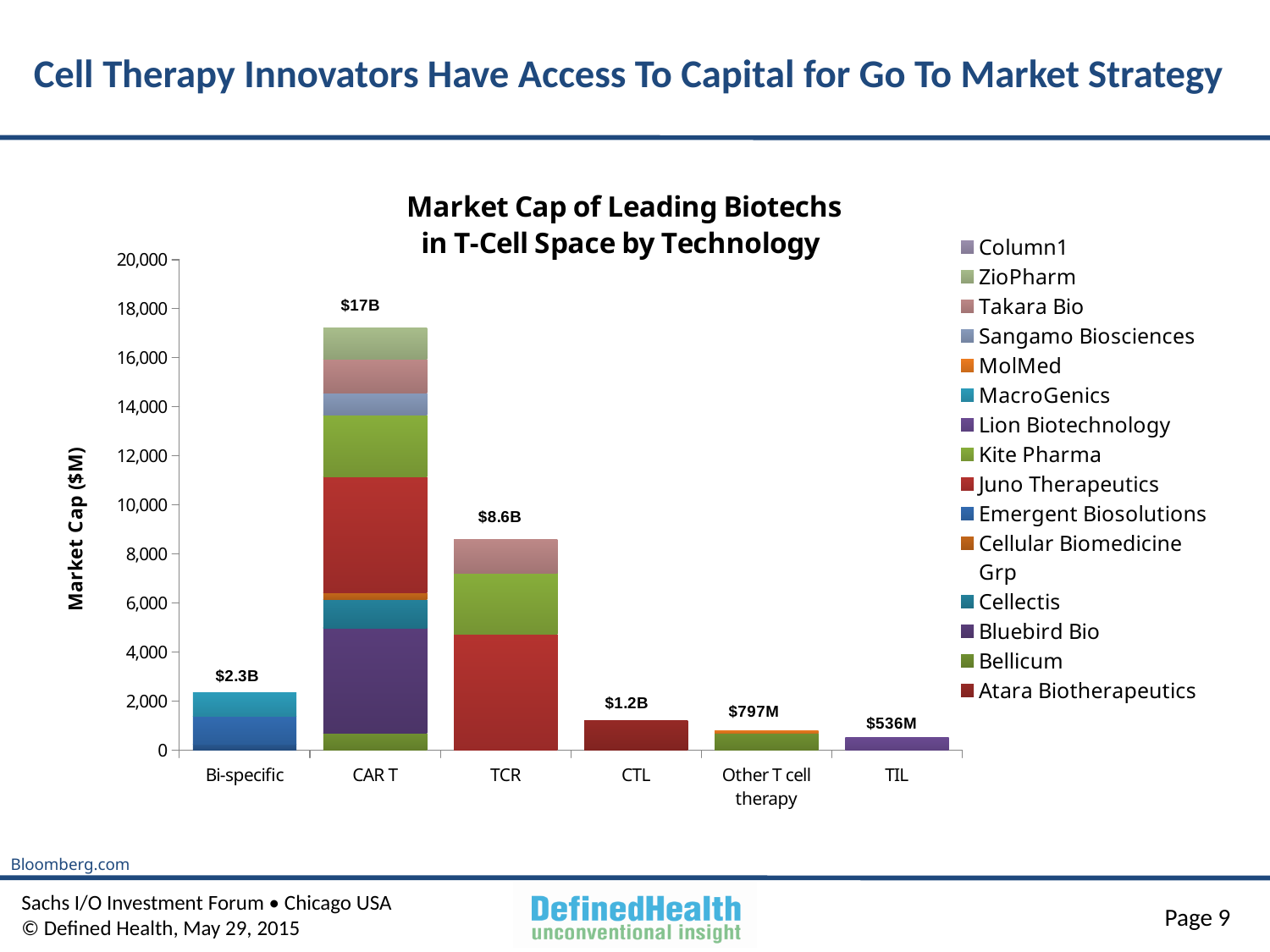
Which technology category has the lowest total market cap? TIL Which has a larger total market cap, Bi-specific or CTL? Bi-specific What is the total market cap shown for the TCR bar? $8.6B How many entries does the legend list? 15 What type of chart is shown on the slide? Stacked bar chart What is the total market cap shown for the Other T cell therapy bar? $797M What is the total market cap shown for the CAR T bar? $17B Which technology category has the highest total market cap? CAR T Is the total for the TCR bar greater or less than 8,000 on the y axis? greater How many technology categories are shown on the x axis? 6 What is the total market cap shown for the TIL bar? $536M